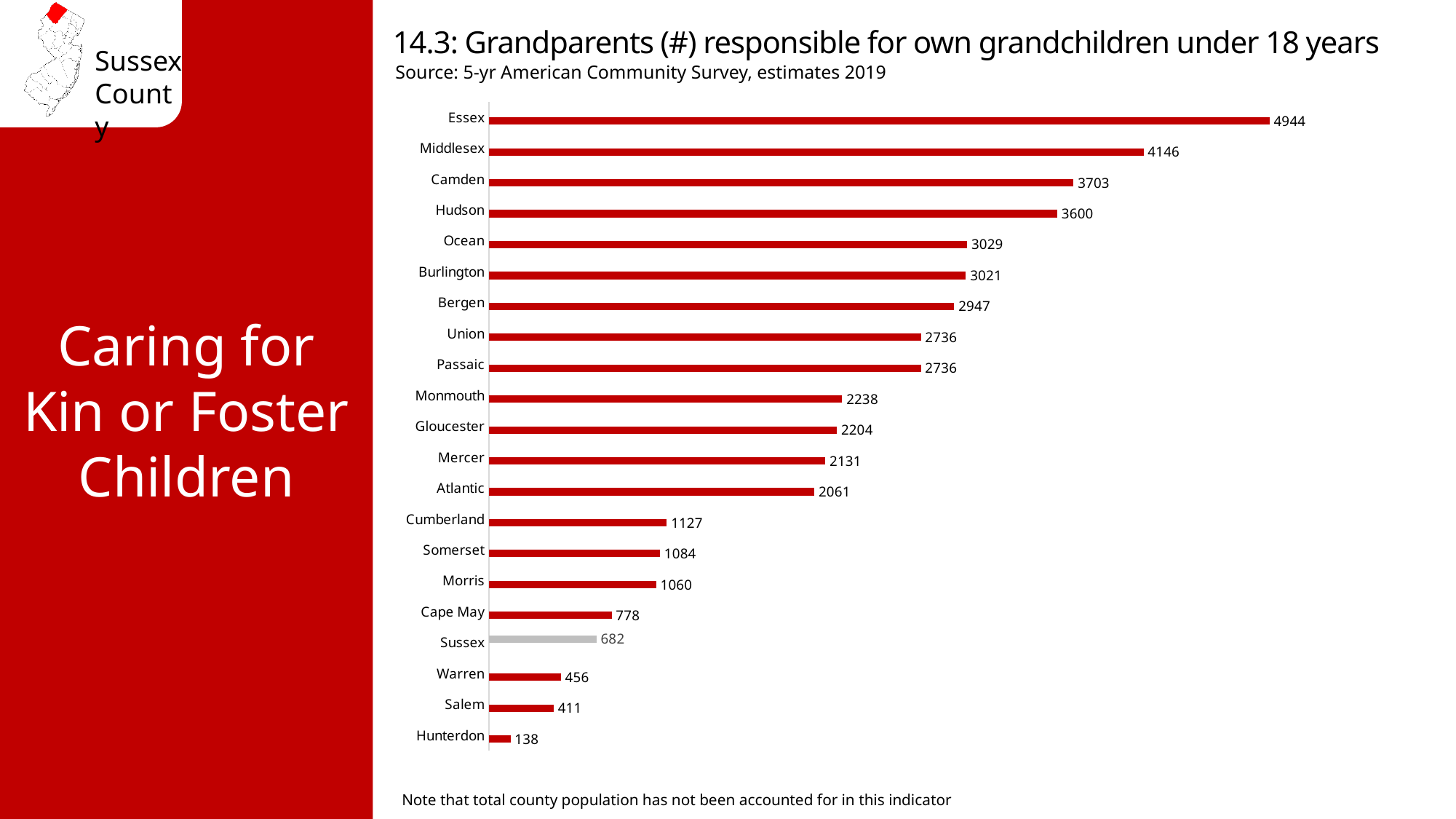
What kind of chart is shown on the slide? Bar chart Which county's bar is shown in grey rather than red? Sussex Which county has the highest value? Essex Which is larger, the value for Morris or the value for Cape May? Morris What is the value for Cape May? 778 What is the difference between the values for Essex and Middlesex? 798 Which county has the lowest value? Hunterdon What is the difference between the values for Sussex and Warren? 226 What is the value for Essex? 4944 Which is larger, the value for Camden or the value for Hudson? Camden How many counties are shown in the chart? 21 What is the value for Sussex? 682